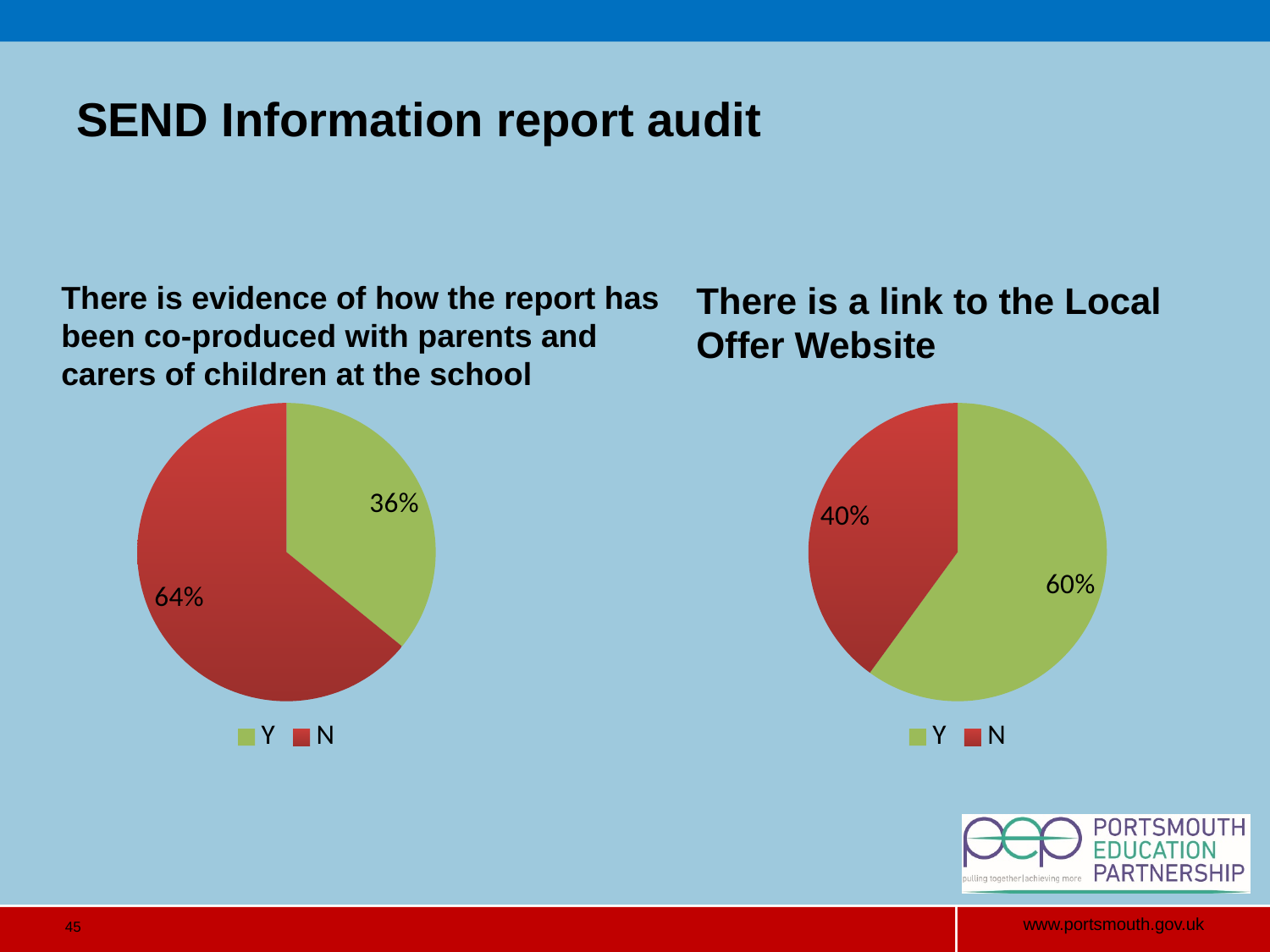
How many slices does the left pie chart (co-produced with parents and carers) have? 2 How many entries does the legend of the right pie chart (link to the Local Offer Website) list? 2 In the left pie chart (co-produced with parents and carers), what is the difference in percentage points between N and Y? 28 In the right pie chart (link to the Local Offer Website), what percentage is shown for Y? 60% In the left pie chart (co-produced with parents and carers), what colour represents N? Red What type of chart is used on the right side of the slide for the Local Offer Website question? Pie chart In the left pie chart (co-produced with parents and carers), what percentage is shown for Y? 36% In the left pie chart (co-produced with parents and carers), what percentage is shown for N? 64% In the right pie chart (link to the Local Offer Website), what is the difference in percentage points between Y and N? 20 In the right pie chart (link to the Local Offer Website), which slice is larger, Y or N? Y In the left pie chart (co-produced with parents and carers), which slice is larger, Y or N? N In the right pie chart (link to the Local Offer Website), what percentage is shown for N? 40%